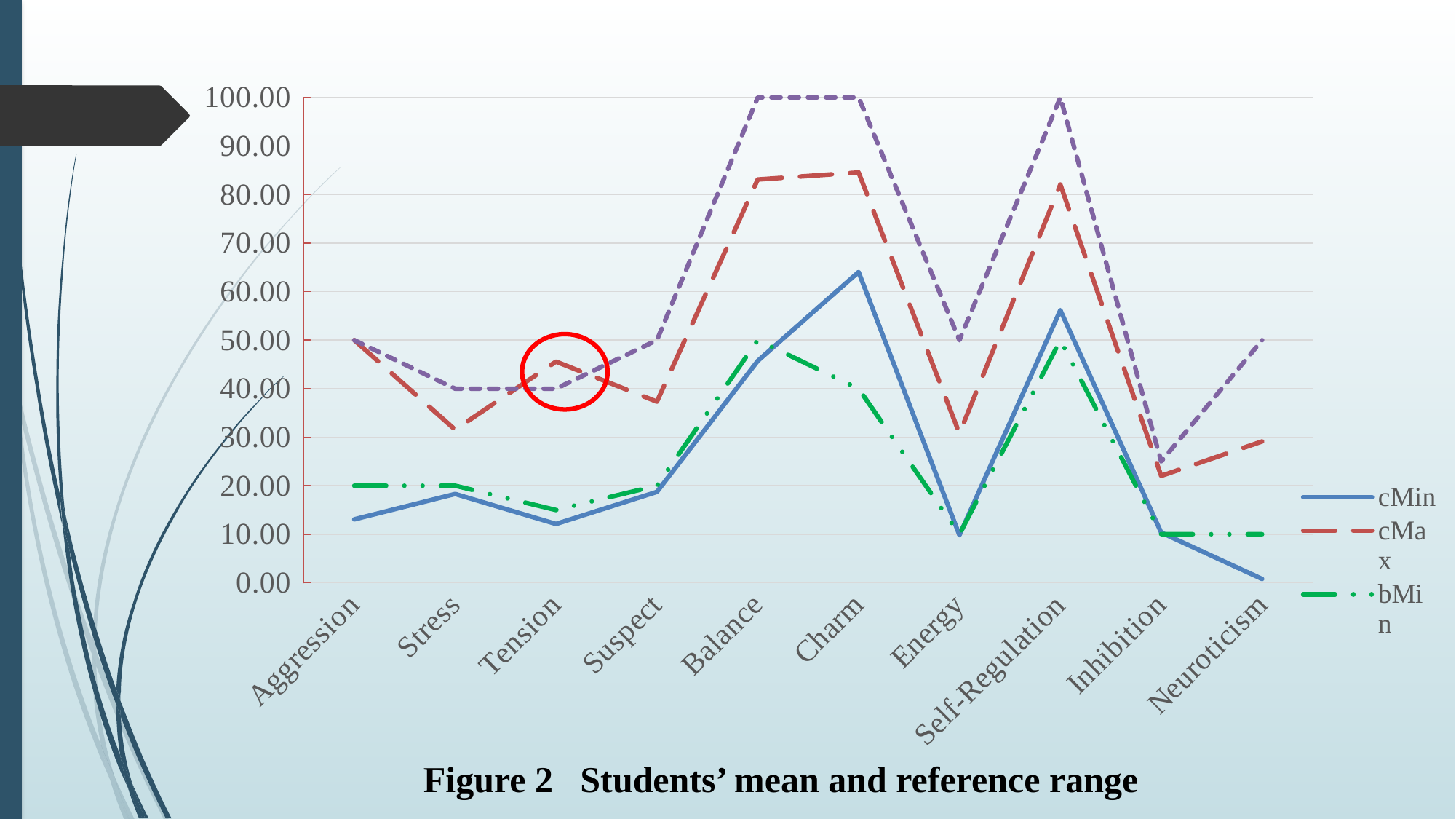
What kind of chart is shown on the slide? line chart What is the bMin value for Aggression? 20.00 Is the cMin value for Aggression greater or less than 20? less For which category is the cMax series lowest? Inhibition Is the cMax value for Charm greater or less than 80? greater For which category is the cMin series highest? Charm At Aggression, which is larger: the bMin value or the cMin value? bMin For which category is the cMin series lowest? Neuroticism What is the caption of the chart? Figure 2 Students' mean and reference range What is the bMin value for Neuroticism? 10.00 How many series does the chart's legend list? 3 How many categories are shown on the x axis of the chart? 10